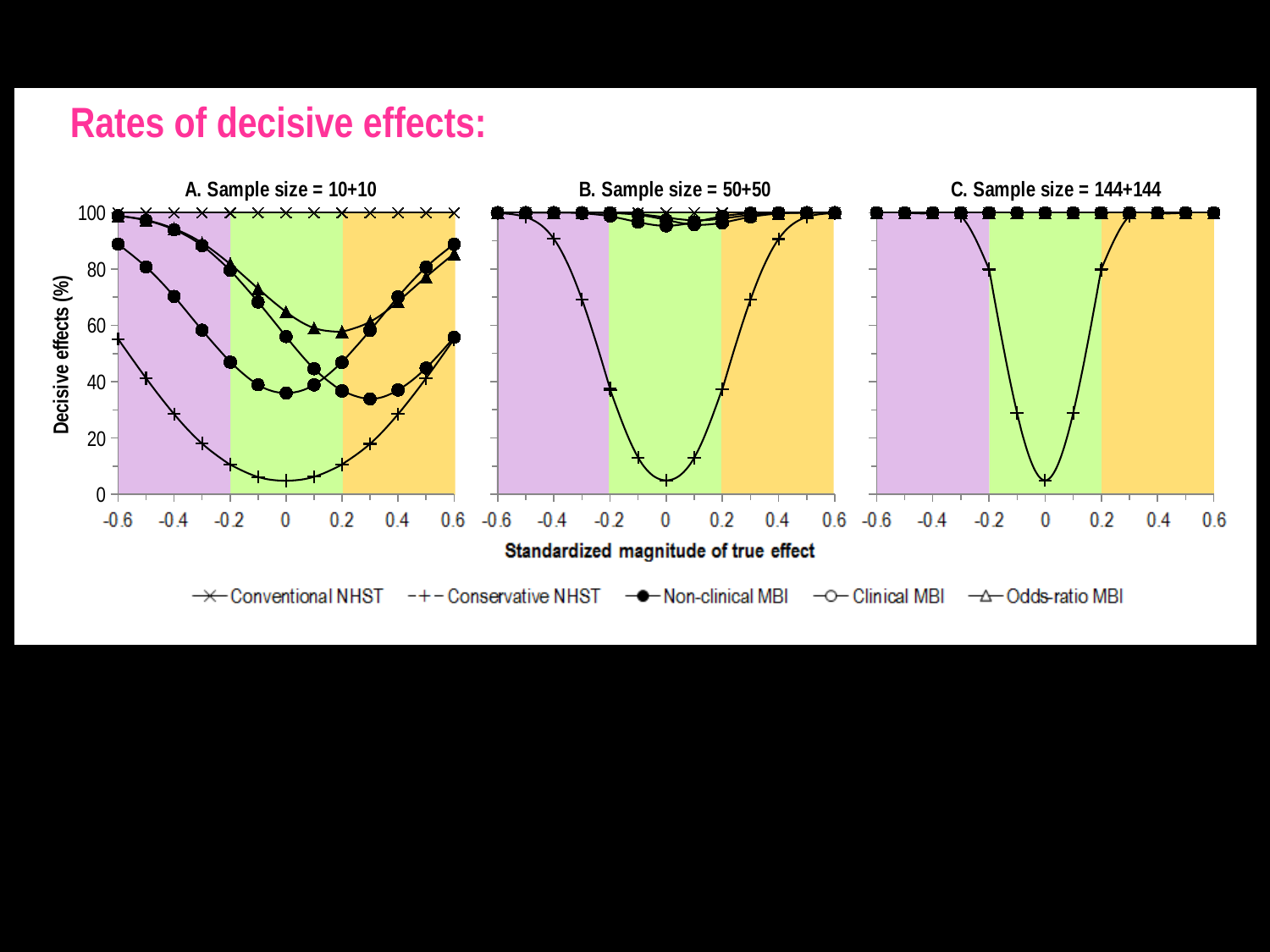
What is the title of the rightmost panel? C. Sample size = 144+144 In panel A (Sample size = 10+10), is the value for Conservative NHST at a true effect of 0 greater or less than 20? less What kind of chart is shown in panel A (Sample size = 10+10)? line chart In panel C (Sample size = 144+144), does the Conservative NHST line rise or fall as the true effect goes from 0 to 0.6? rise In panel B (Sample size = 50+50), which is larger at a true effect of 0: Conventional NHST or Conservative NHST? Conventional NHST What is the label on the y axis of the charts? Decisive effects (%) In panel A (Sample size = 10+10), is the value for Conventional NHST at a true effect of 0 greater or less than 80? greater How many series does the legend list for the charts? 5 In panel C (Sample size = 144+144), is the value for Conservative NHST at a true effect of 0 greater or less than 20? less In panel A (Sample size = 10+10), which series has the highest value at a true effect of 0? Conventional NHST In panel A (Sample size = 10+10), which series has the lowest value at a true effect of 0? Conservative NHST